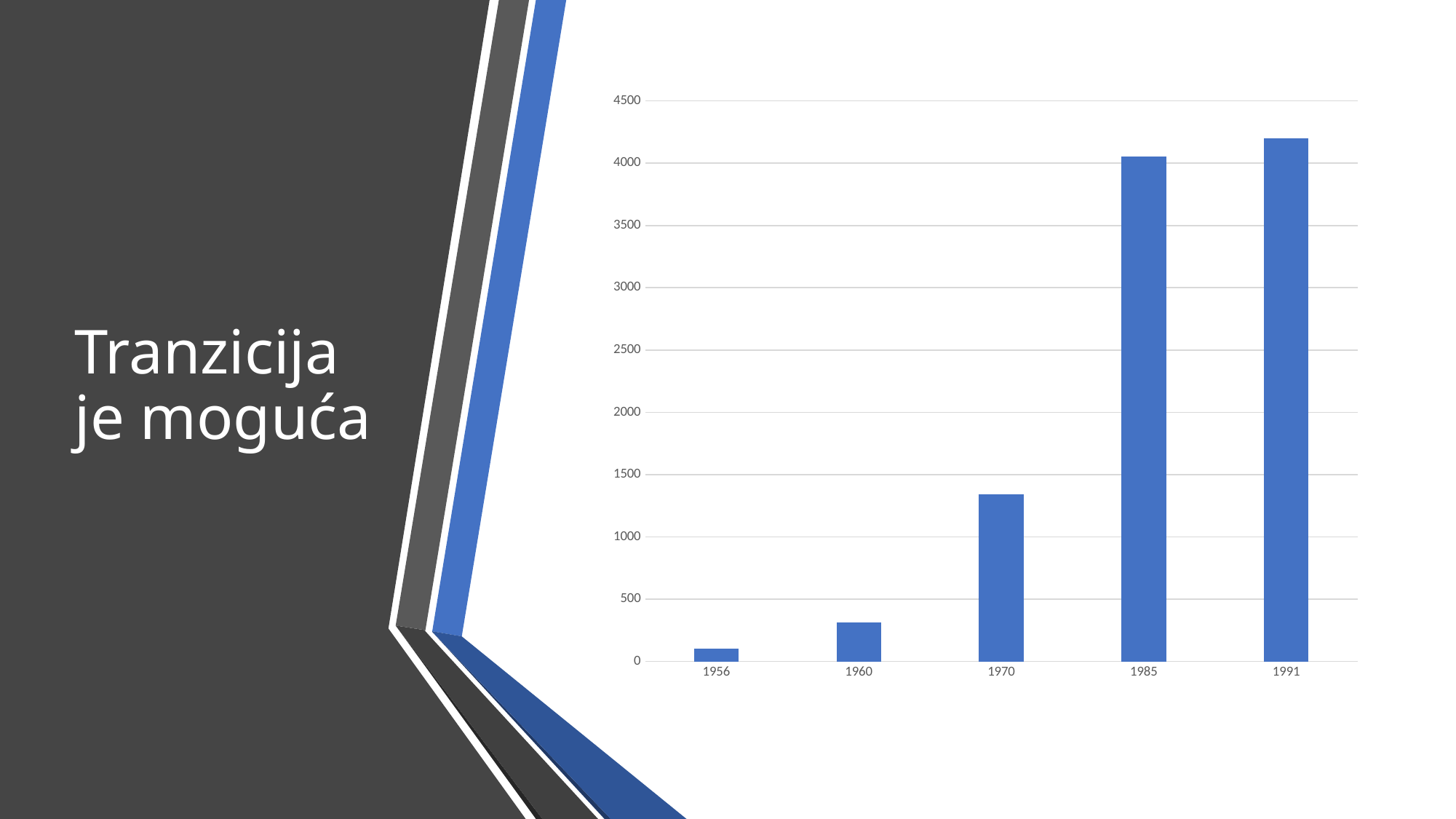
Is the value for 1991 greater or less than 4500? less Is the value for 1970 greater or less than 1500? less Which is larger, the value for 1970 or the value for 1960? 1970 Which year has the lowest bar in the chart? 1956 How many categories (years) are shown on the x axis of the chart? 5 Which is larger, the value for 1985 or the value for 1970? 1985 Is the value for 1970 greater or less than 1000? greater Which year has the highest bar in the chart? 1991 What kind of chart is shown on the slide? bar chart Do the values rise or fall from 1956 to 1991 along the x axis? rise